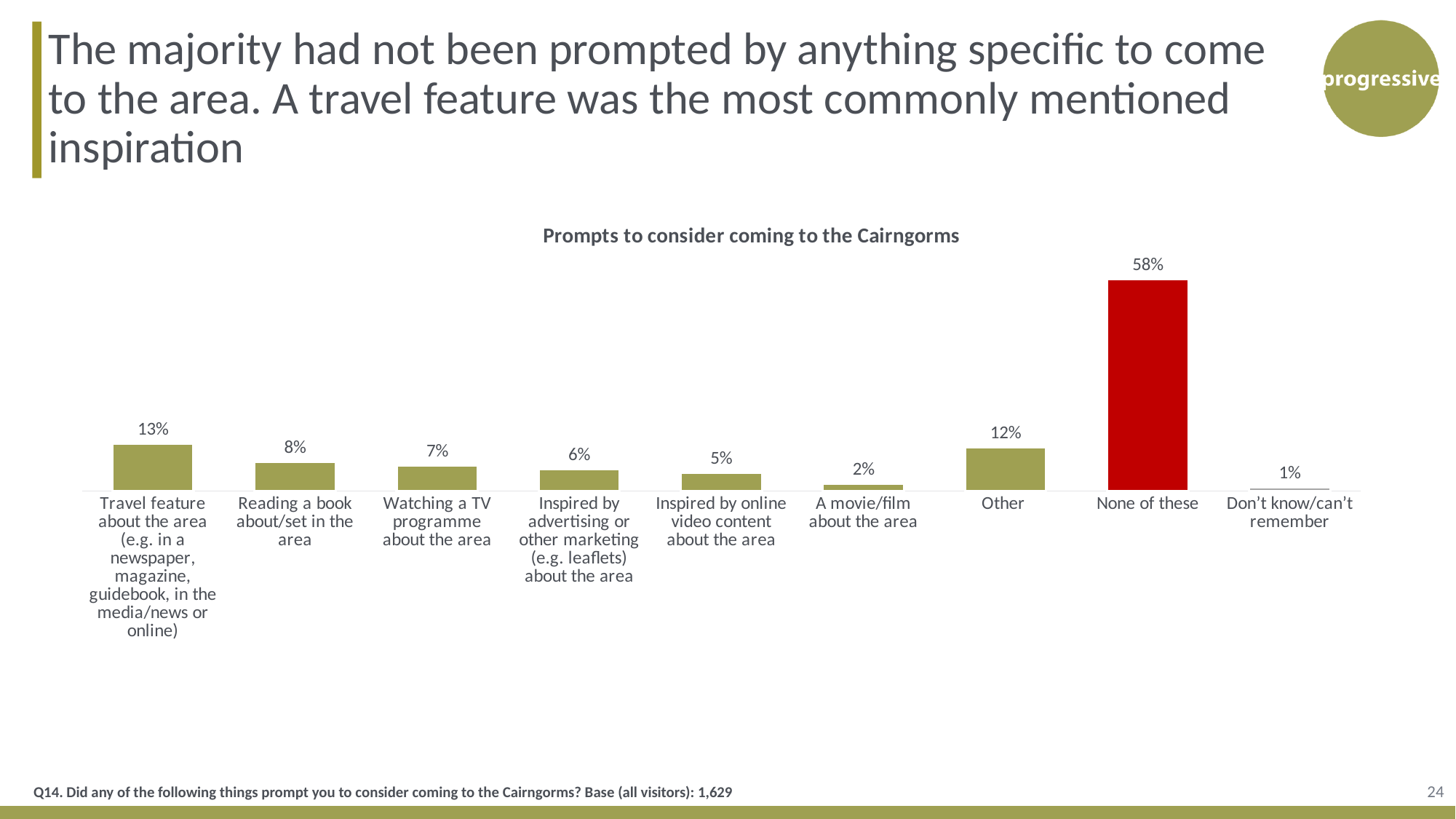
What is the title of the chart? Prompts to consider coming to the Cairngorms Which category has the highest value? None of these What is the difference between 'None of these' and 'Travel feature about the area'? 45% Which is larger: 'Other' or 'Reading a book about/set in the area'? Other What is the value for 'A movie/film about the area'? 2% What is the value for 'None of these'? 58% What is the value for 'Watching a TV programme about the area'? 7% What is the difference between 'Reading a book about/set in the area' and 'Inspired by online video content about the area'? 3% What percentage of visitors were prompted by a travel feature about the area? 13% What kind of chart is shown on the slide? Bar chart How many categories are shown in the chart? 9 Which category has the lowest value? Don't know/can't remember